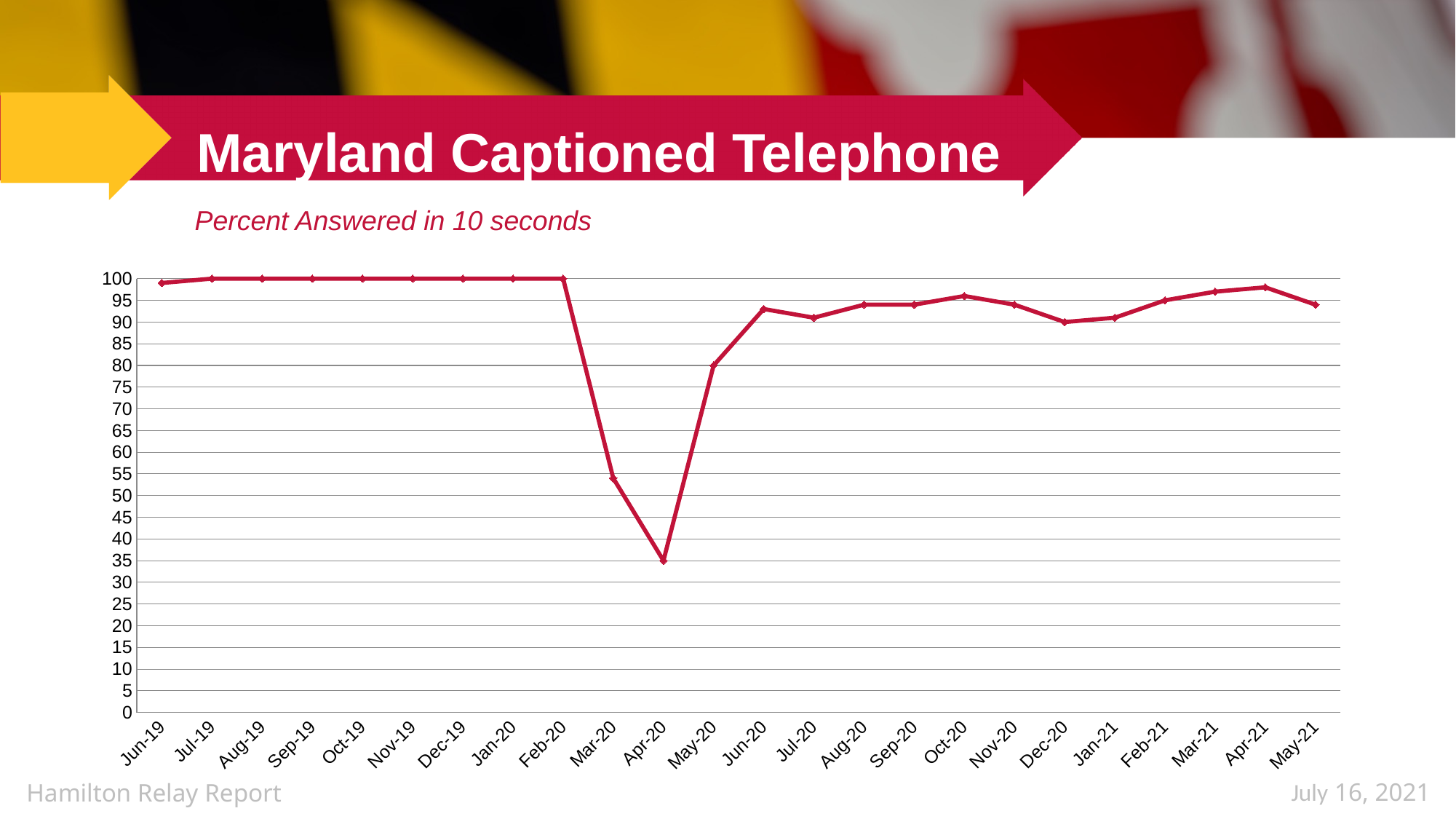
Is the value for Jun-20 greater or less than 90? greater What metric does the chart's subtitle say is plotted? Percent Answered in 10 seconds Do the values rise or fall from Apr-20 to Jun-20? rise What is the percent answered in 10 seconds for May-20? 80 What kind of chart is shown on the slide? line chart Which month has the lowest percent answered in 10 seconds? Apr-20 Do the values rise or fall from Feb-20 to Apr-20? fall Is the value for Mar-20 greater or less than 60? less What is the percent answered in 10 seconds for Feb-20? 100 What is the percent answered in 10 seconds for Apr-20? 35 How many months are plotted along the x axis? 24 Which month has the higher value, Mar-20 or May-20? May-20